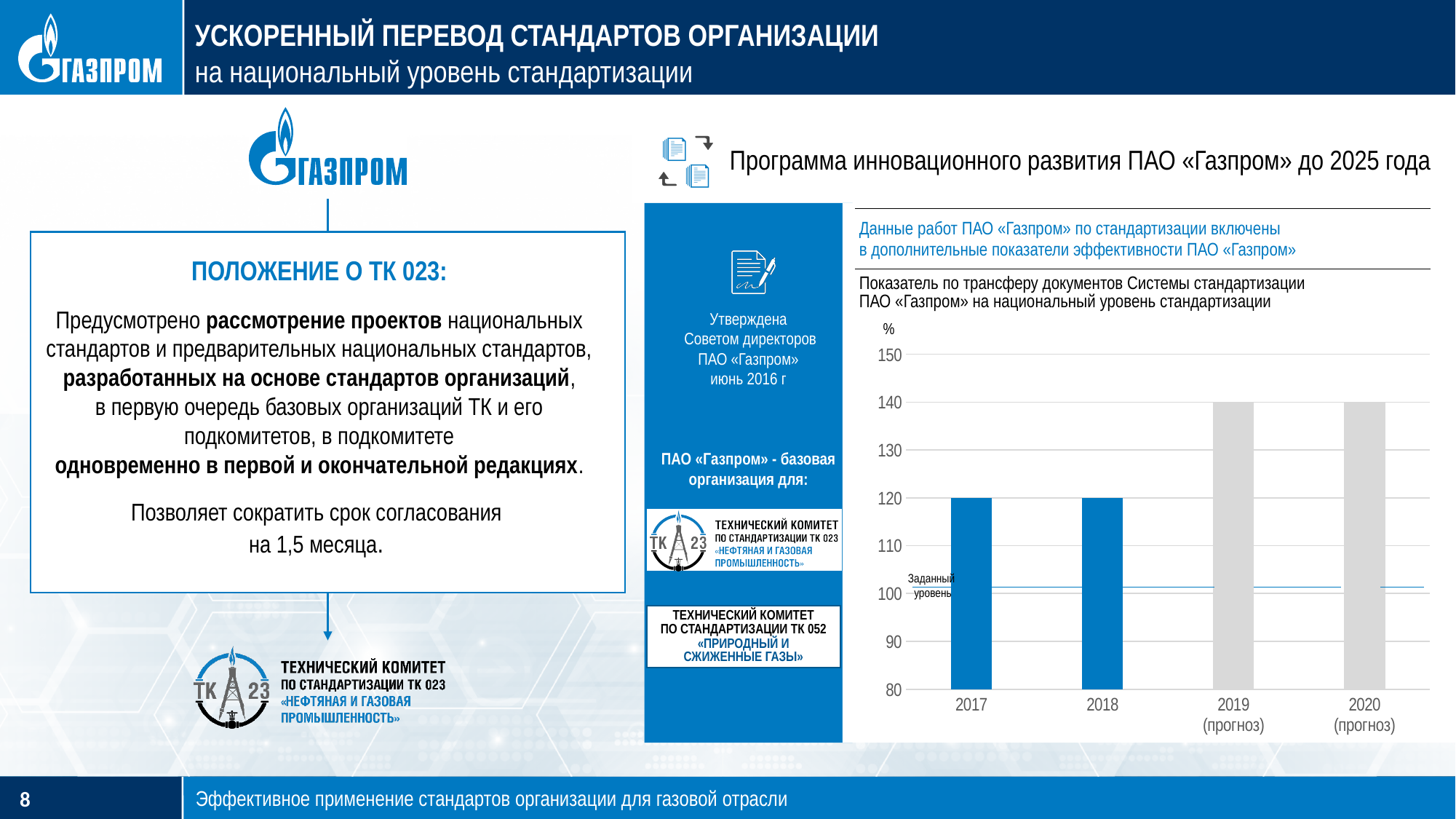
What is the difference between the value for 2020 (прогноз) and the value for 2017? 20 What is the label of the horizontal reference line drawn across the chart? Заданный уровень How many categories (years) are shown on the x axis of the chart? 4 What value does the bar for 2017 reach on the chart? 120 Is the value for 2018 greater or less than 110? greater What kind of chart is shown on the slide? bar chart What value does the bar for 2019 (прогноз) reach on the chart? 140 What unit is shown at the top of the y axis of the chart? % Is the value for 2019 (прогноз) greater or less than 130? greater What value does the bar for 2020 (прогноз) reach on the chart? 140 Which is larger on the chart, the value for 2018 or the value for 2019 (прогноз)? 2019 (прогноз) Do the values rise or fall from 2017 to 2020 (прогноз) on the chart? rise